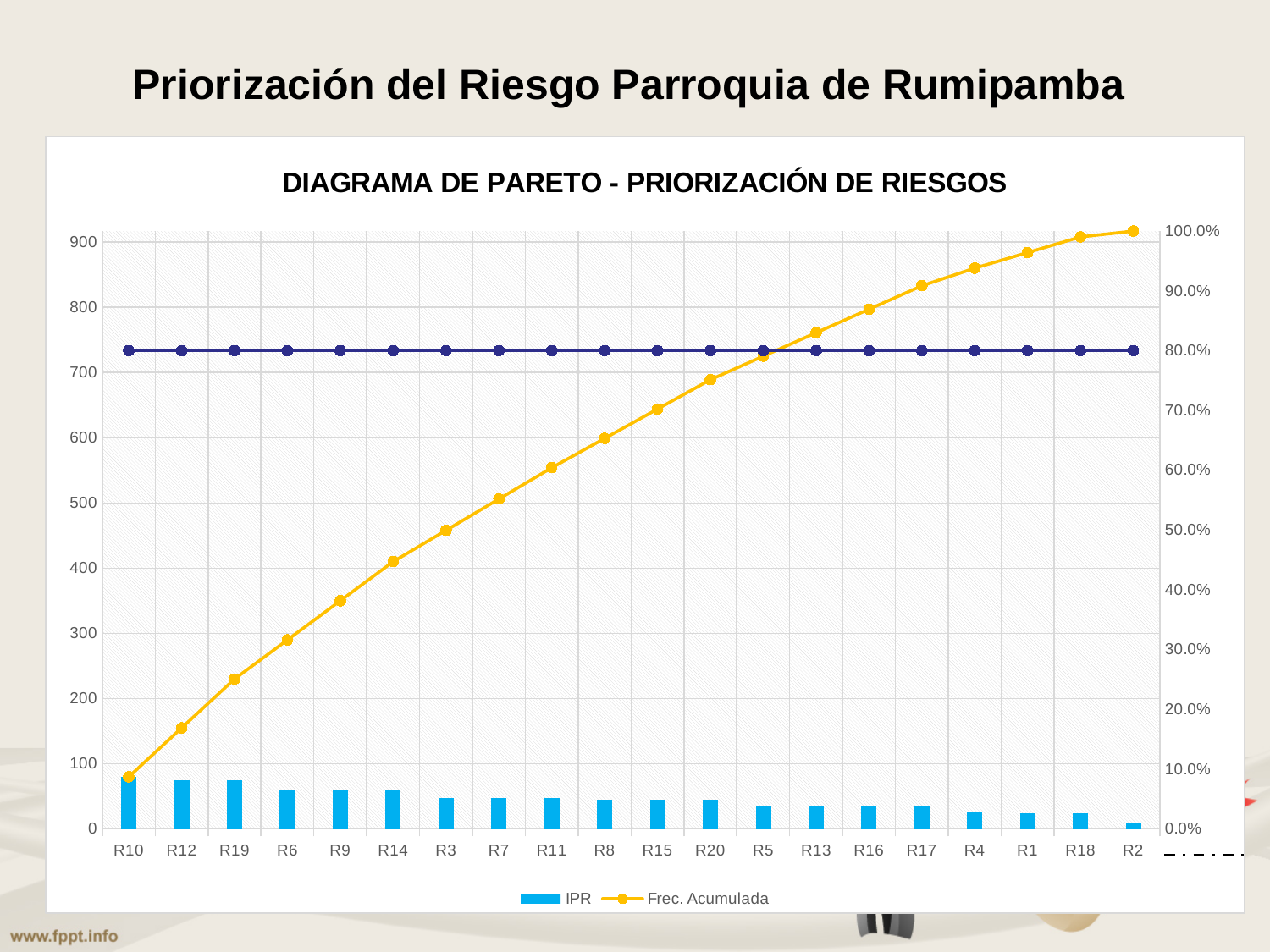
Is the Frec. Acumulada value at R19 greater or less than 30.0%? less Which category has the highest IPR bar? R10 Is the IPR value for R10 greater or less than 50? greater How many risk categories are shown on the x axis? 20 What value does the Frec. Acumulada line reach at R2? 100.0% Which category has the lowest IPR bar? R2 Do the IPR bars rise or fall from left to right along the x axis? fall Which has a larger IPR value, R6 or R4? R6 What kind of chart is this? A combined bar and line chart (Pareto chart) What is the title of the chart? DIAGRAMA DE PARETO - PRIORIZACIÓN DE RIESGOS How many series does the legend list? 2 Is the IPR value for R10 greater or less than 100? less